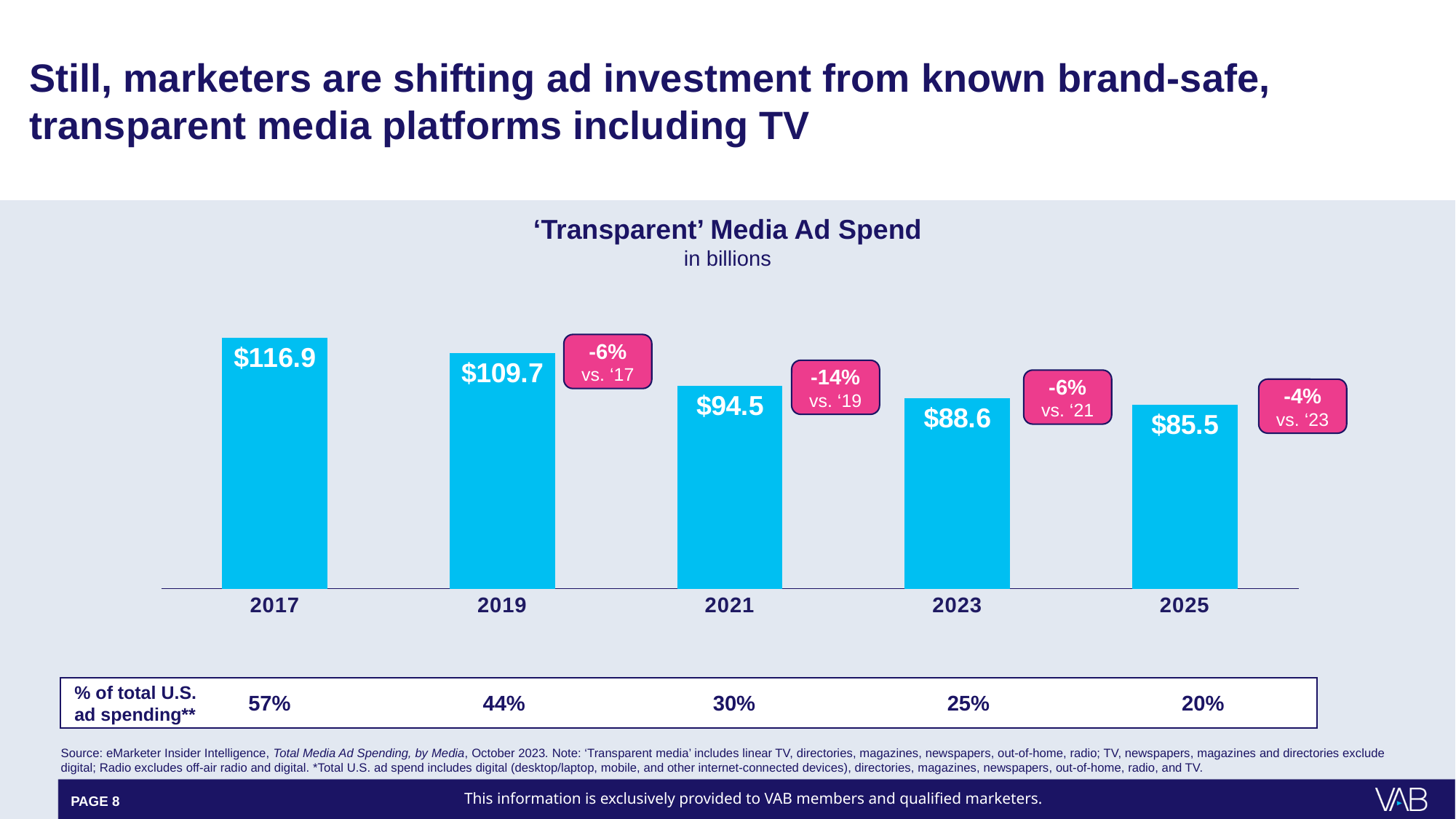
What unit is stated in the subtitle of the chart? in billions Which year has the highest 'Transparent' Media Ad Spend? 2017 Which year has the lowest 'Transparent' Media Ad Spend? 2025 What is the 'Transparent' Media Ad Spend value for 2017? $116.9 What is the 'Transparent' Media Ad Spend value for 2021? $94.5 Which year has a larger 'Transparent' Media Ad Spend, 2021 or 2023? 2021 What is the difference in 'Transparent' Media Ad Spend between 2019 and 2023? $21.1 Do the 'Transparent' Media Ad Spend values rise or fall from 2017 to 2025? Fall How many years are shown on the x axis of the chart? 5 What percentage change vs. '19 is shown for 2021? -14% What kind of chart is used to show 'Transparent' Media Ad Spend? Bar chart What is the 'Transparent' Media Ad Spend value for 2025? $85.5